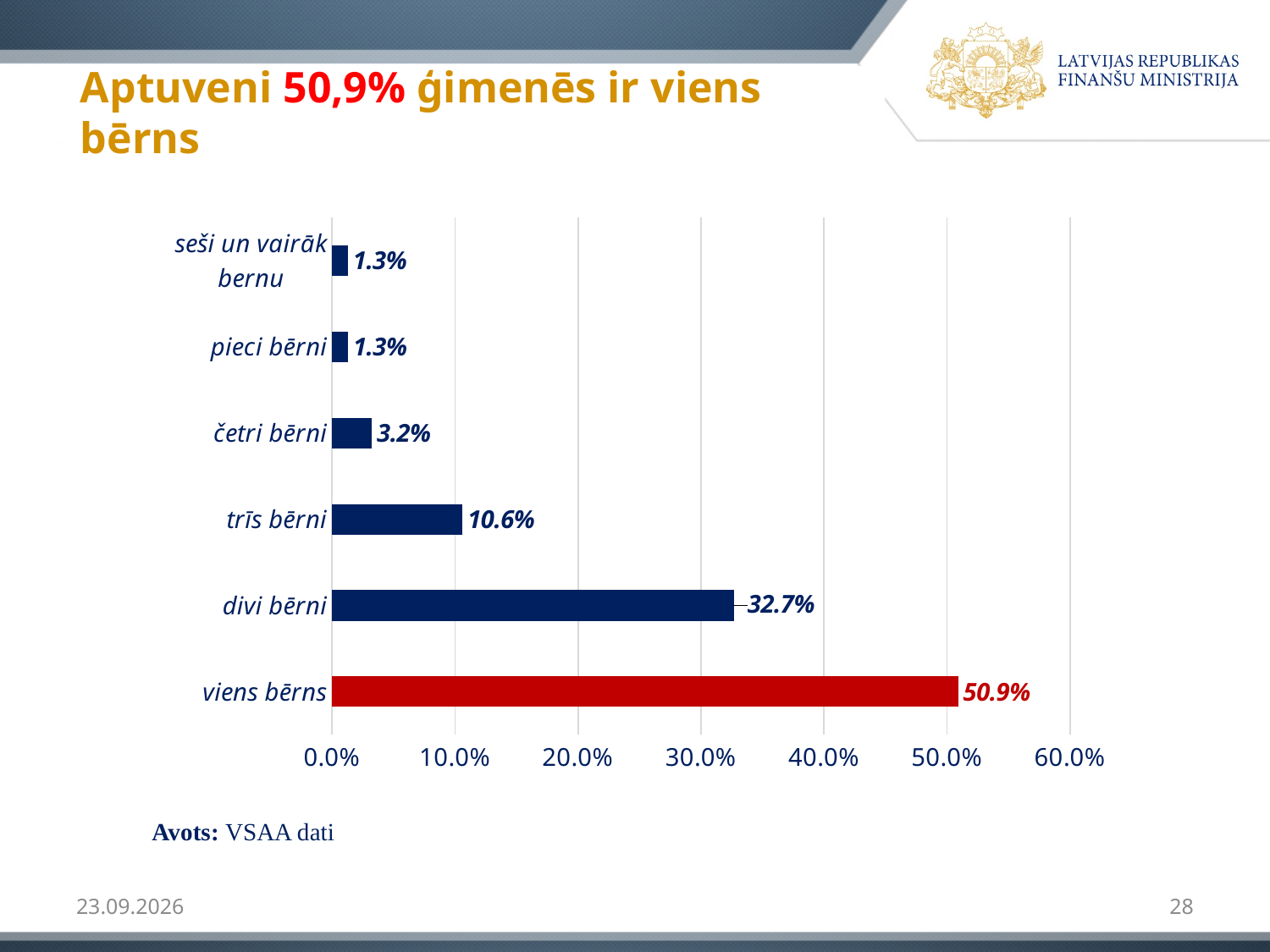
Which is larger, the value for "trīs bērni" or the value for "četri bērni"? trīs bērni How many categories are shown in the chart? 6 Is the value for "divi bērni" greater or less than 30.0%? greater What is the value for "pieci bērni"? 1.3% What is the value for "trīs bērni"? 10.6% Which bar is coloured red rather than dark blue? viens bērns What is the value for "divi bērni"? 32.7% What is the value for "četri bērni"? 3.2% What is the difference between the values for "viens bērns" and "divi bērni"? 18.2% What is the value for "viens bērns"? 50.9% What kind of chart is shown on the slide? bar chart Which category has the highest value? viens bērns